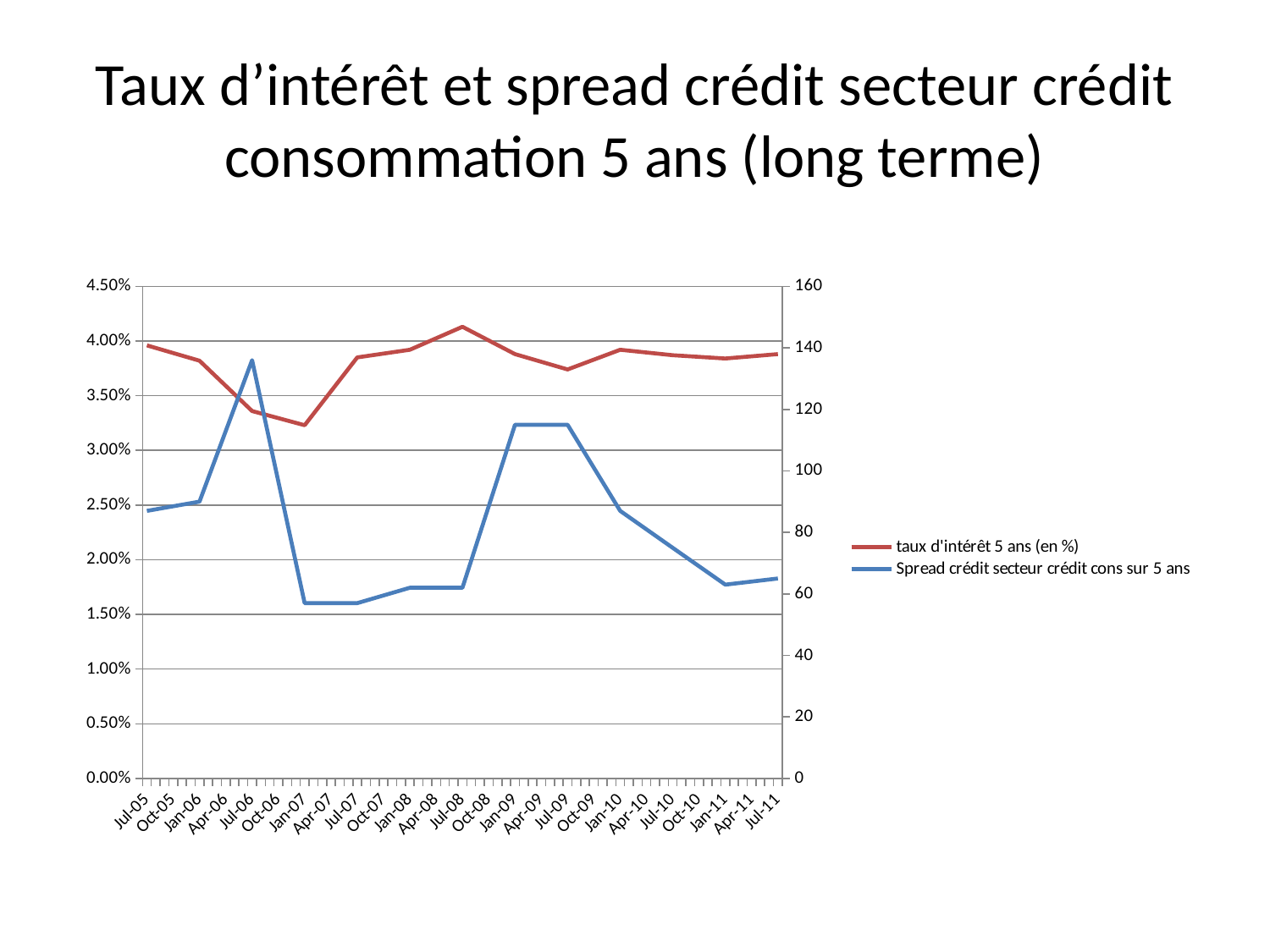
How many series does the legend list? 2 Is the value of 'taux d'intérêt 5 ans (en %)' at Jul-08 greater or less than 4.00%? greater What kind of chart is shown on the slide? line chart What is the highest value shown on the right-hand axis? 160 At which date does the 'Spread crédit secteur crédit cons sur 5 ans' series reach its highest value? Jul-06 Is the value of 'Spread crédit secteur crédit cons sur 5 ans' at Jul-06 greater or less than 120? greater Does the 'Spread crédit secteur crédit cons sur 5 ans' series rise or fall between Jul-06 and Jan-07? fall At which date does the 'taux d'intérêt 5 ans (en %)' series reach its lowest value? Jan-07 Which series is drawn in blue? Spread crédit secteur crédit cons sur 5 ans At which date does the 'taux d'intérêt 5 ans (en %)' series reach its highest value? Jul-08 Is the value of 'Spread crédit secteur crédit cons sur 5 ans' at Jan-07 greater or less than 80? less